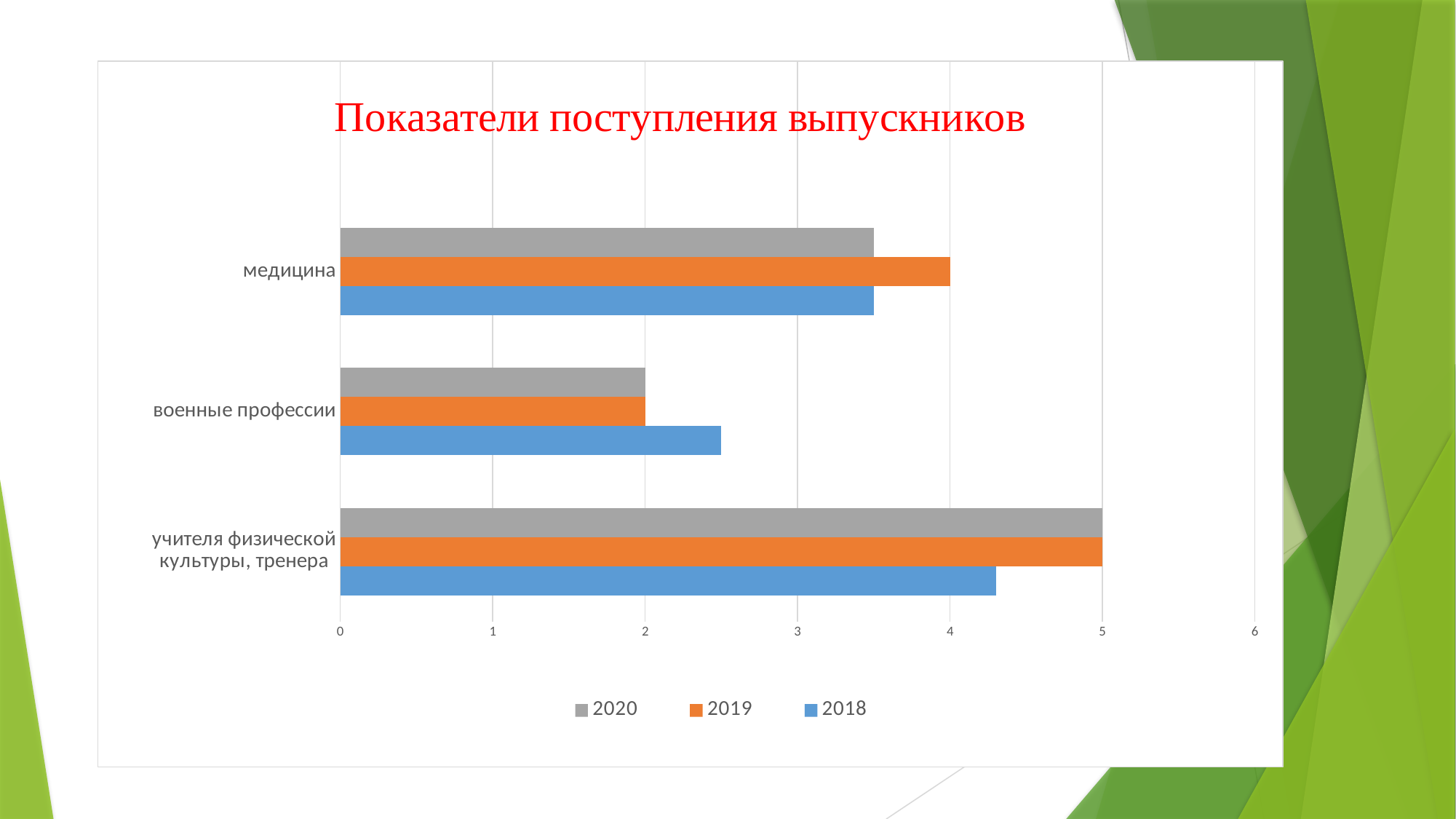
What is the value for военные профессии in the 2019 series? 2 How many series does the legend list? 3 In the 2019 series, what is the difference between учителя физической культуры, тренера and медицина? 1 What kind of chart is shown on the slide? bar chart What is the value for медицина in the 2019 series? 4 What is the title of the chart? Показатели поступления выпускников Is the value for медицина in the 2018 series greater or less than 3? greater How many categories are shown on the vertical axis? 3 Which category has the highest value in the 2018 series? учителя физической культуры, тренера What is the value for учителя физической культуры, тренера in the 2020 series? 5 Is the value for учителя физической культуры, тренера in the 2018 series greater or less than 5? less Which category has the lowest value in the 2020 series? военные профессии